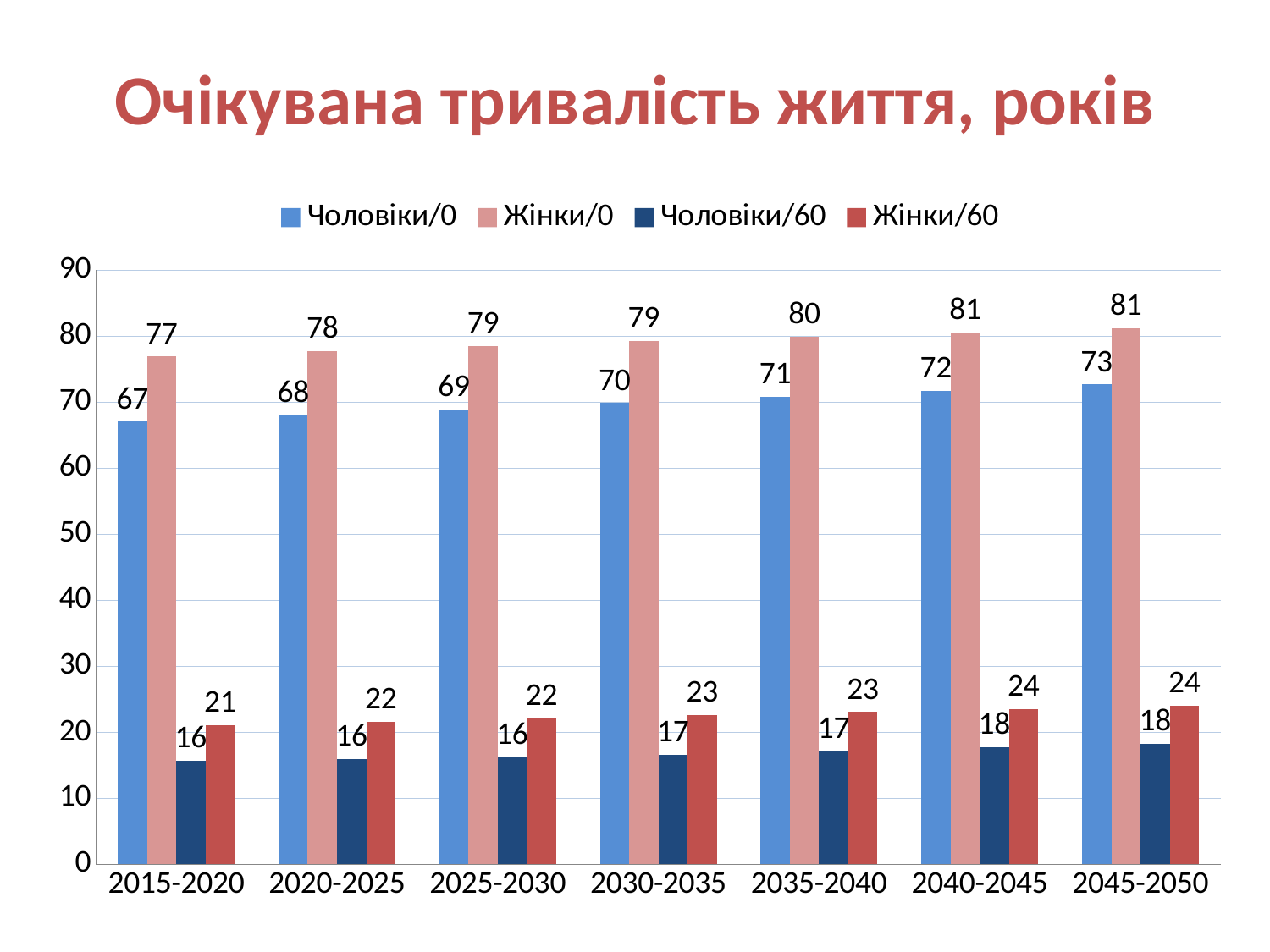
How many periods are shown on the x axis? 7 Do the values for Чоловіки/0 rise or fall from 2015-2020 to 2045-2050? rise How many series does the legend list? 4 What is the value for Жінки/60 in 2035-2040? 23 What is the value for Чоловіки/60 in 2045-2050? 18 What is the value for Жінки/0 in 2015-2020? 77 What is the value for Чоловіки/0 in 2030-2035? 70 In which period is the value for Чоловіки/0 the lowest? 2015-2020 What is the difference between Жінки/60 and Чоловіки/60 in 2015-2020? 5 Which is larger in 2025-2030: the value for Чоловіки/0 or the value for Жінки/0? Жінки/0 What is the difference between Жінки/0 and Чоловіки/0 in 2045-2050? 8 What kind of chart is shown on the slide? bar chart